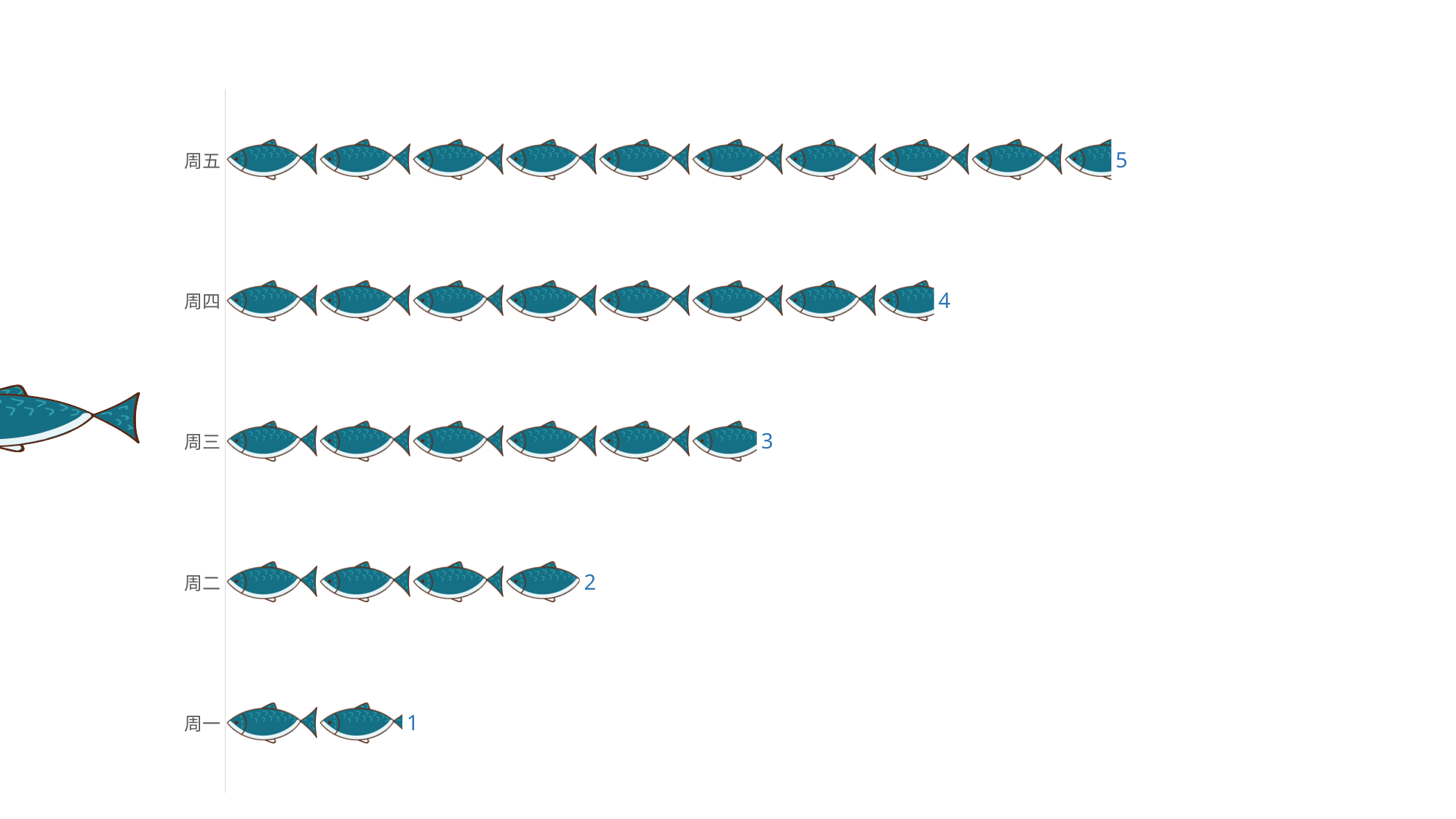
How many categories are shown in the chart? 5 What icon is used to represent the bars in the chart? fish Which category has the lowest value? 周一 What is the value for 周三? 3 What is the value for 周二? 2 Which category has the highest value? 周五 What is the value for 周五? 5 What is the difference between the values for 周四 and 周一? 3 What kind of chart is this? bar chart What is the difference between the values for 周五 and 周二? 3 Which is larger, the value for 周四 or the value for 周三? 周四 What is the value for 周一? 1